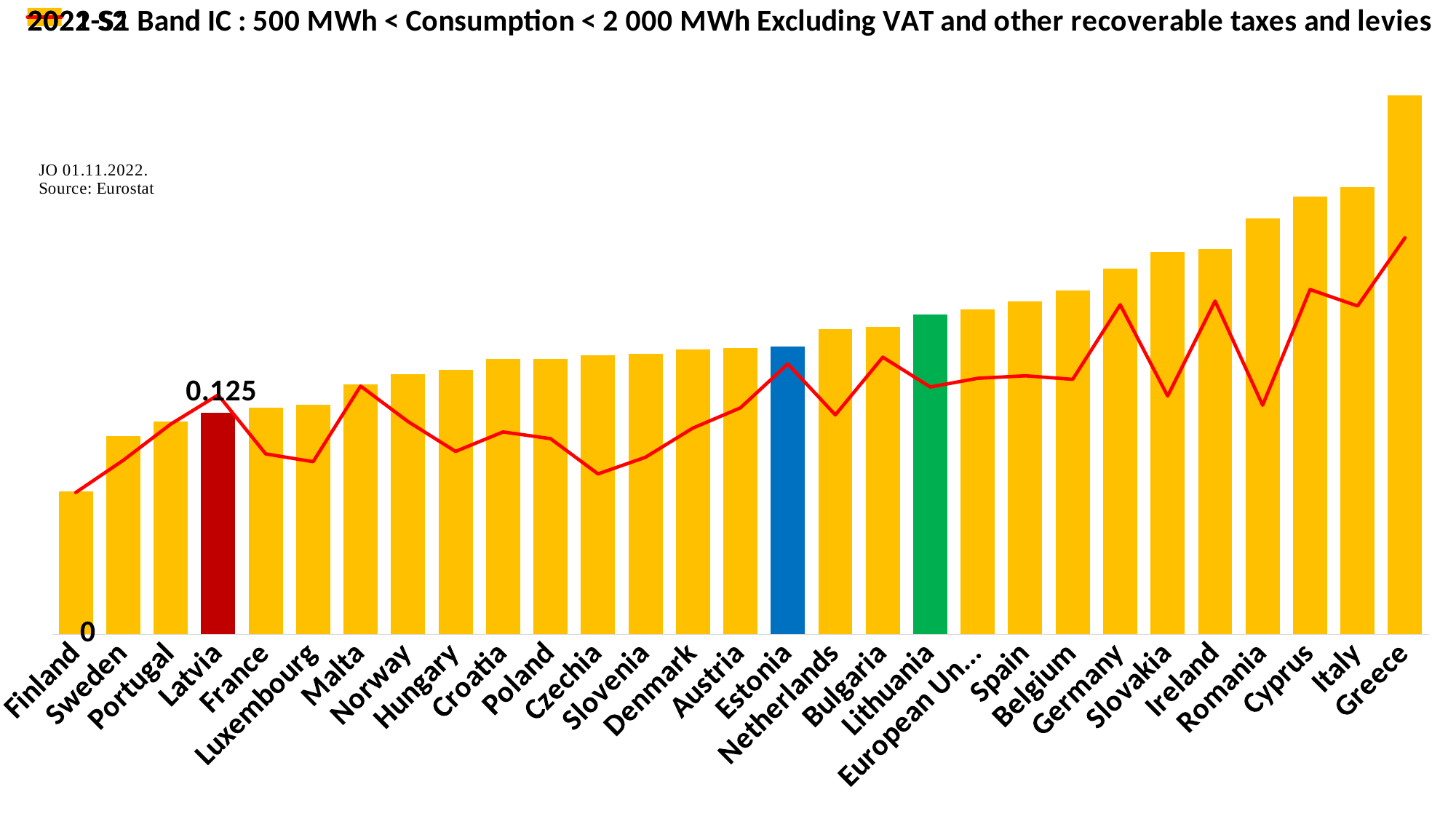
What value is labelled on the Latvia bar? 0.125 Which country's bar is coloured blue? Estonia What kind of chart is this? Bar chart with a line overlay What colour is the Latvia bar? Red Do the bar values generally rise or fall from left to right along the x axis? Rise Which country has the lowest bar? Finland Which country has the highest bar? Greece How many countries/categories are shown on the x axis? 29 Which bar is taller, Sweden or Portugal? Portugal Which country has the second highest bar? Italy Which bar is taller, Finland or Greece? Greece Which bar is taller, Germany or Spain? Germany